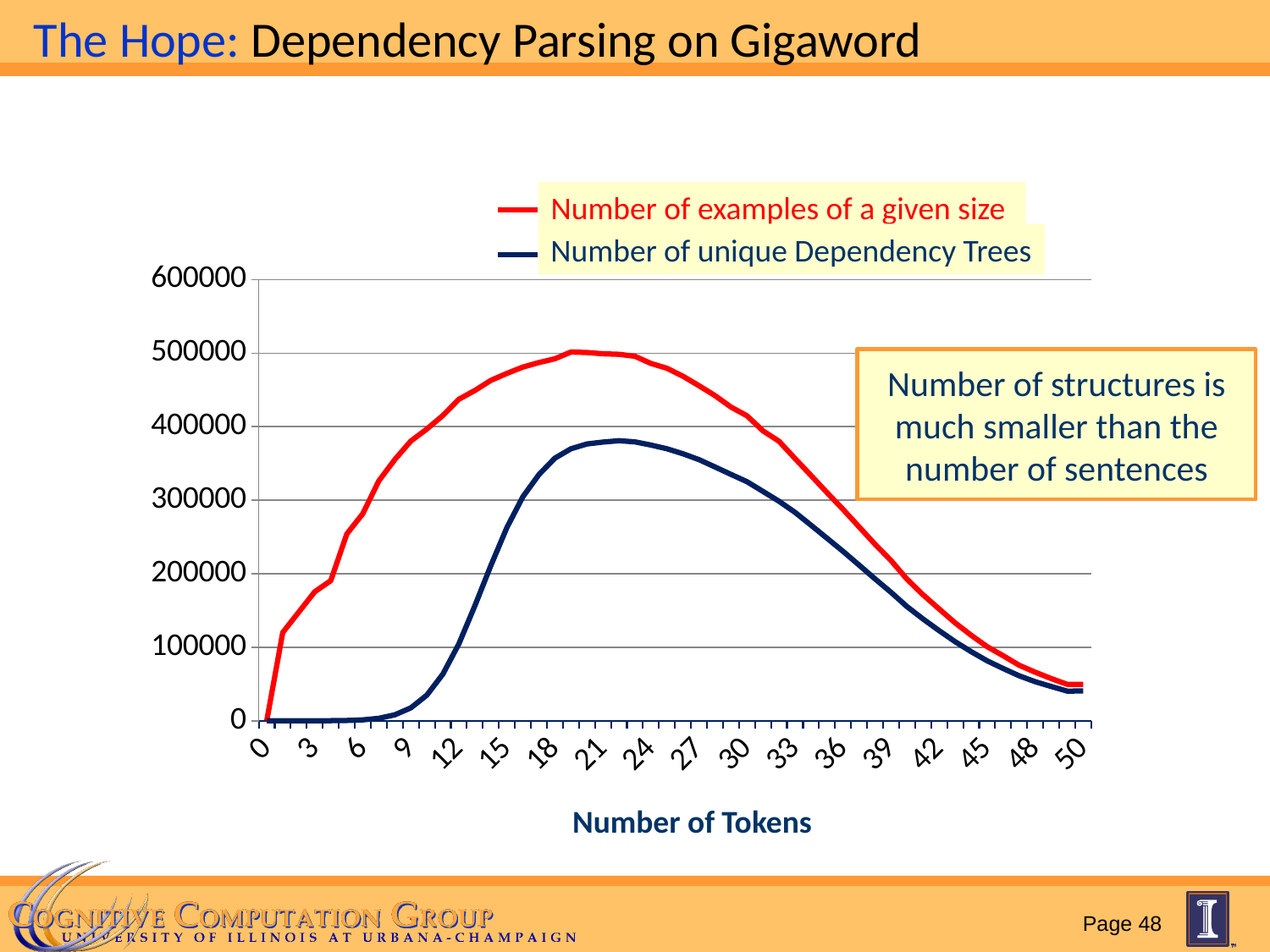
Is the value of Number of unique Dependency Trees at 42 tokens greater or less than 100000? greater Is the value of Number of examples of a given size at 12 tokens greater or less than 400000? greater Is the value of Number of examples of a given size at 3 tokens greater or less than 100000? greater What kind of chart is shown on the slide? line chart At 21 tokens, which series has the larger value: Number of examples of a given size or Number of unique Dependency Trees? Number of examples of a given size Does the Number of examples of a given size rise or fall between 24 and 50 tokens? fall What is the title of the x axis? Number of Tokens Which series is drawn in red? Number of examples of a given size How many series does the legend list? 2